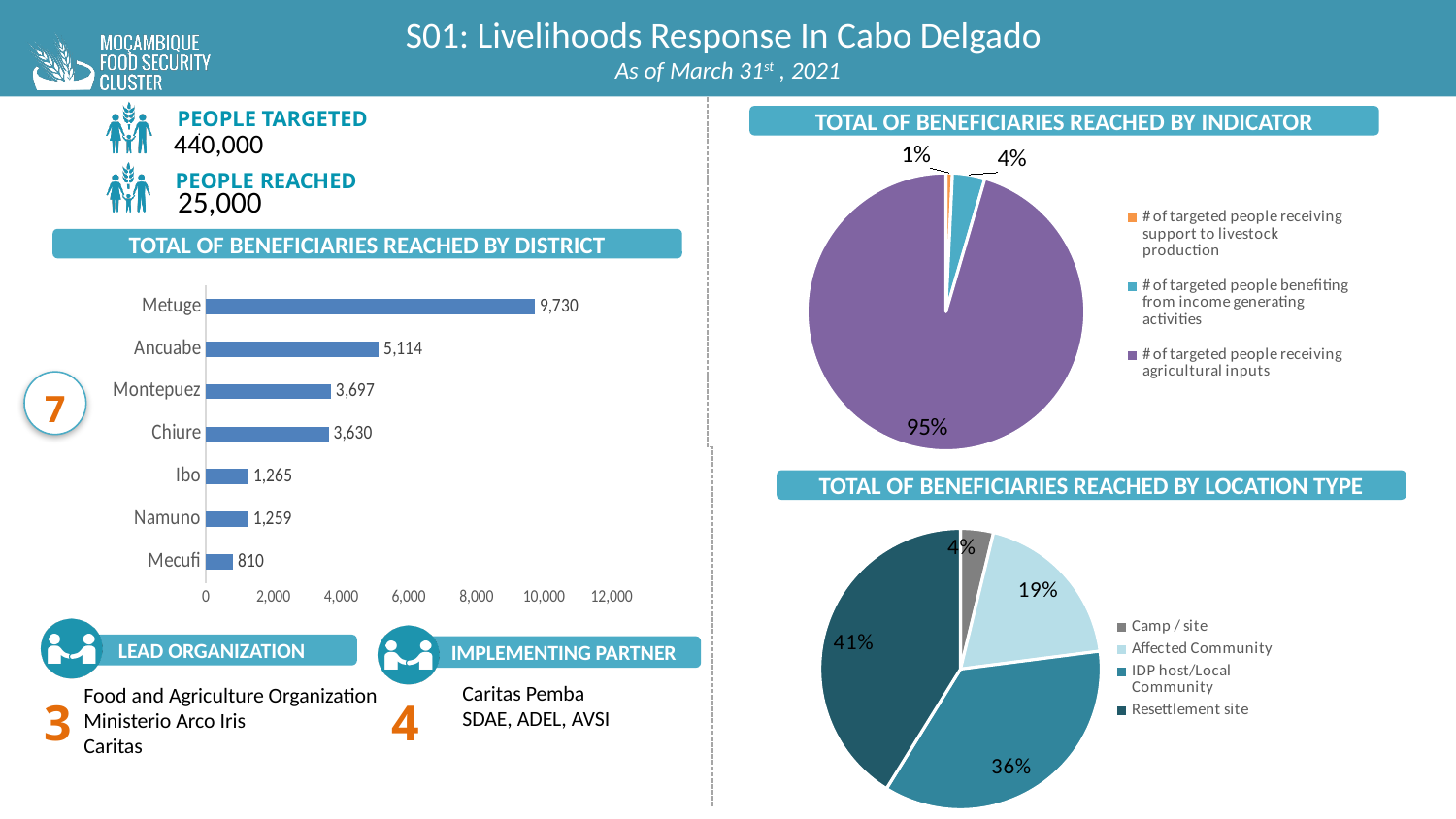
In the 'Total of beneficiaries reached by district' chart, how many districts are shown? 7 In the 'Total of beneficiaries reached by district' chart, what is the difference between the values for Metuge and Ancuabe? 4,616 In the 'Total of beneficiaries reached by district' chart, how many beneficiaries were reached in Metuge? 9,730 In the 'Total of beneficiaries reached by location type' pie chart, which location type has the smallest share? Camp / site In the 'Total of beneficiaries reached by indicator' pie chart, what share is for targeted people receiving agricultural inputs? 95% In the 'Total of beneficiaries reached by district' chart, which district has the highest number of beneficiaries reached? Metuge In the 'Total of beneficiaries reached by indicator' pie chart, what share is for targeted people benefiting from income generating activities? 4% In the 'Total of beneficiaries reached by district' chart, which district has the lowest number of beneficiaries reached? Mecufi What type of chart is the 'Total of beneficiaries reached by district' chart? Bar chart In the 'Total of beneficiaries reached by district' chart, how many beneficiaries were reached in Chiure? 3,630 In the 'Total of beneficiaries reached by location type' pie chart, what share is for Resettlement site? 41% How many entries does the legend of the 'Total of beneficiaries reached by location type' pie chart list? 4